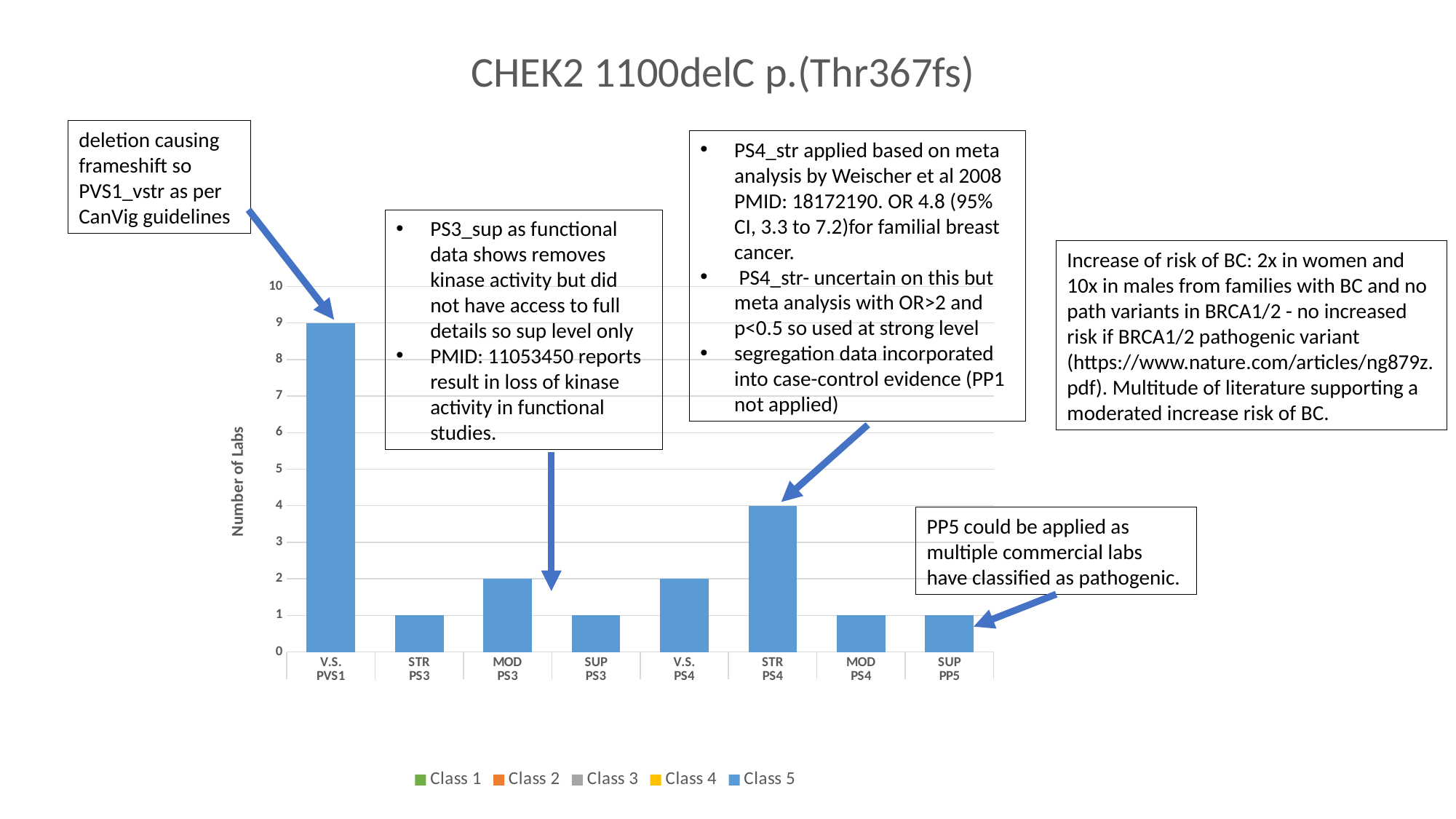
How many labs are shown for V.S. PVS1? 9 Which category has the highest number of labs? V.S. PVS1 Is the value for V.S. PVS1 greater or less than 5? greater What is the difference in number of labs between V.S. PVS1 and STR PS4? 5 Which has more labs, STR PS4 or V.S. PS4? STR PS4 How many series does the legend list? 5 How many categories are shown on the x axis? 8 How many labs are shown for MOD PS3? 2 How many labs are shown for STR PS4? 4 What type of chart is shown on the slide? bar chart What is the label of the vertical axis? Number of Labs What is the title of the slide? CHEK2 1100delC p.(Thr367fs)